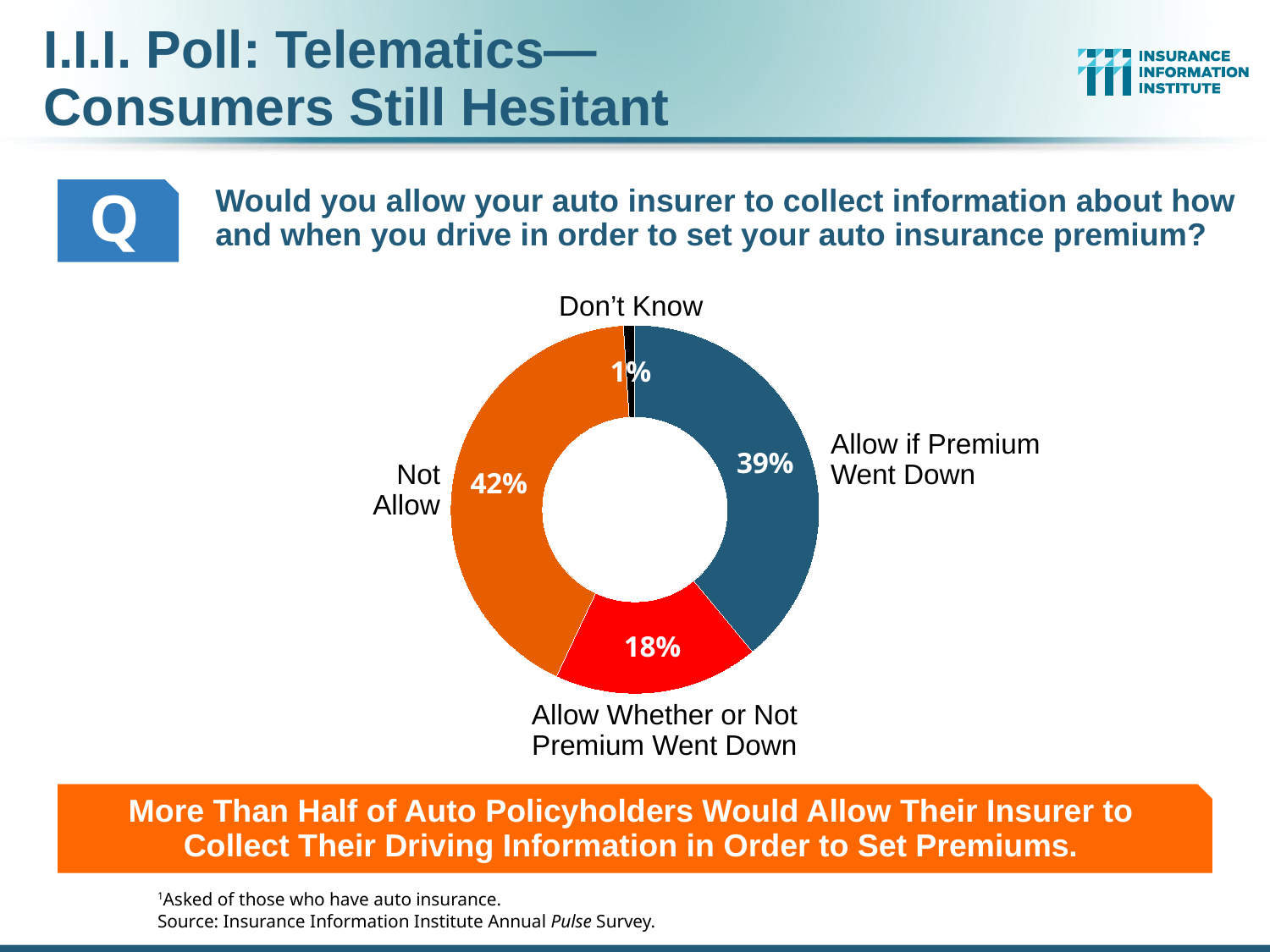
What percentage of respondents would Allow if Premium Went Down? 39% Which response has the largest share of the chart? Not Allow Which response has the smallest share of the chart? Don't Know What percentage of respondents answered Don't Know? 1% What is the difference in percentage points between Not Allow and Allow if Premium Went Down? 3 percentage points How many response categories are shown in the chart? 4 What percentage of respondents would Allow Whether or Not Premium Went Down? 18% What kind of chart is shown on the slide? Pie chart (doughnut) Which is larger: the share for Allow Whether or Not Premium Went Down or the share for Don't Know? Allow Whether or Not Premium Went Down What percentage of respondents would Not Allow their auto insurer to collect driving information? 42% What is the difference in percentage points between Allow if Premium Went Down and Allow Whether or Not Premium Went Down? 21 percentage points What colour is the slice for Allow Whether or Not Premium Went Down? Red